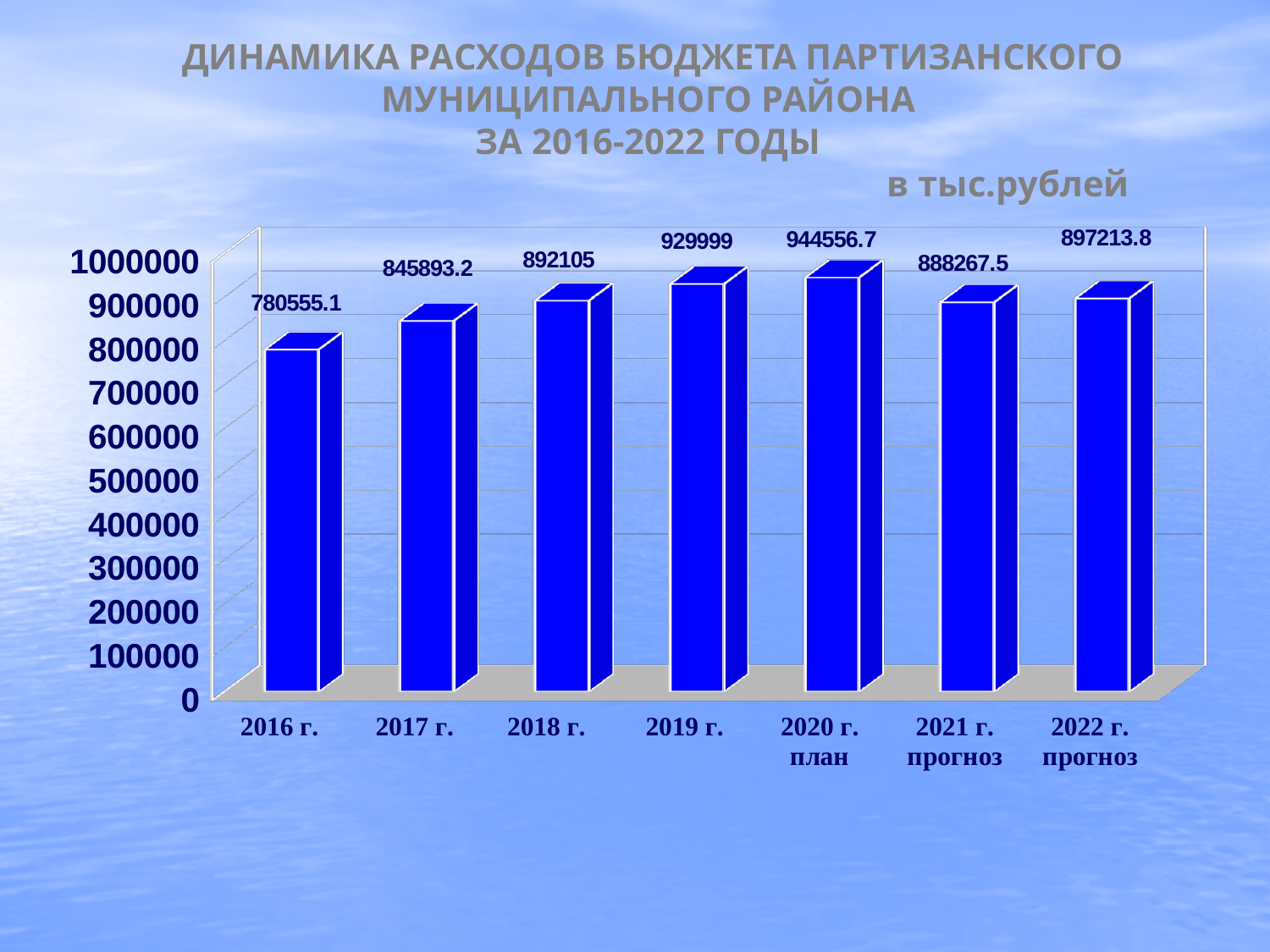
Which is larger, the value for 2021 г. прогноз or the value for 2022 г. прогноз? 2022 г. прогноз What is the value for 2020 г. план? 944556.7 What is the value for 2016 г.? 780555.1 What kind of chart is shown on the slide? bar chart Which year has the highest value? 2020 г. план What is the difference between the values for 2019 г. and 2018 г.? 37894 Is the value for 2017 г. greater or less than 900000? less What is the difference between the values for 2020 г. план and 2016 г.? 164001.6 Do the values rise or fall from 2016 г. to 2020 г. план? rise How many bars are shown in the chart? 7 What is the value for 2022 г. прогноз? 897213.8 Which year has the lowest value? 2016 г.